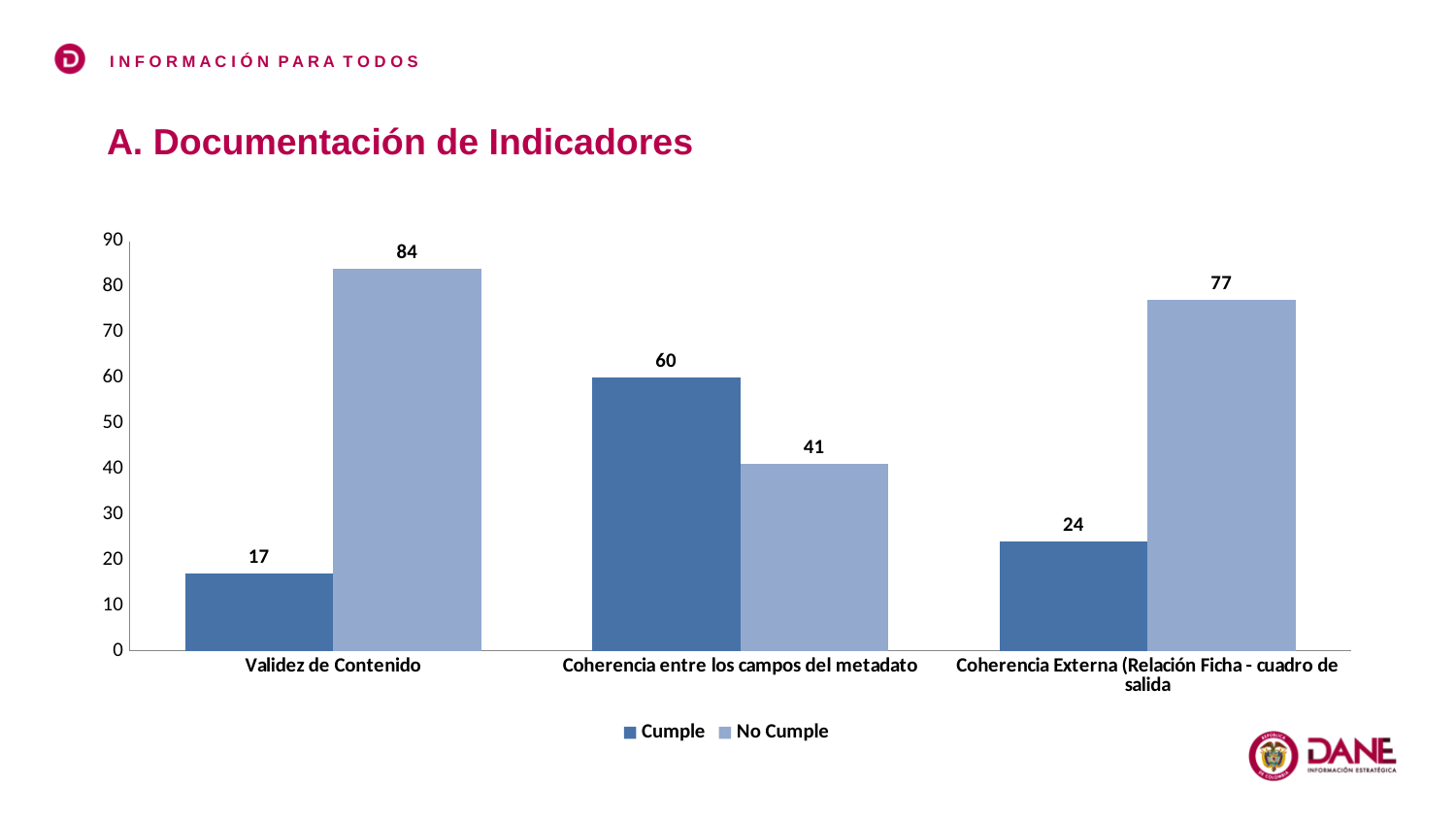
What is the value of Cumple for Validez de Contenido? 17 What is the difference between No Cumple and Cumple for Validez de Contenido? 67 Which is larger for Coherencia Externa (Relación Ficha - cuadro de salida): Cumple or No Cumple? No Cumple Is the Cumple value for Coherencia entre los campos del metadato greater or less than 50? greater What is the value of No Cumple for Coherencia Externa (Relación Ficha - cuadro de salida)? 77 How many series does the legend list? 2 Which category has the lowest Cumple value? Validez de Contenido What kind of chart is shown on the slide? Bar chart What is the value of No Cumple for Coherencia entre los campos del metadato? 41 What is the difference between Cumple and No Cumple for Coherencia entre los campos del metadato? 19 How many categories are shown on the x axis? 3 Which category has the highest No Cumple value? Validez de Contenido